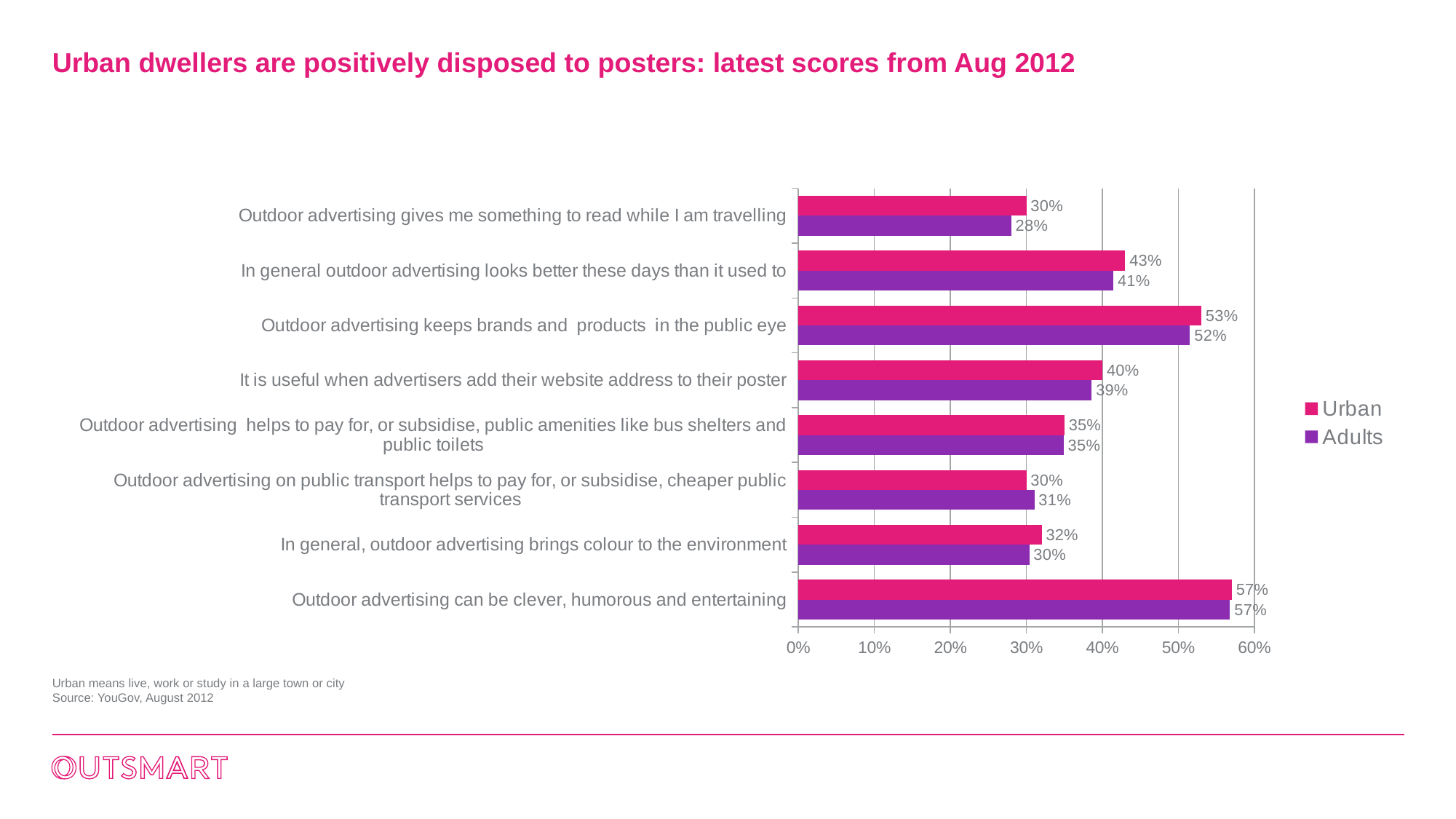
What is the Urban value for "Outdoor advertising keeps brands and products in the public eye"? 53% What is the difference between the Urban and Adults values for "In general outdoor advertising looks better these days than it used to"? 2% How many series does the legend list? 2 What is the Adults value for "It is useful when advertisers add their website address to their poster"? 39% Which statement has the highest Urban value? Outdoor advertising can be clever, humorous and entertaining How many statements (categories) are shown on the chart? 8 For "Outdoor advertising on public transport helps to pay for, or subsidise, cheaper public transport services", which is larger: the Urban value or the Adults value? Adults What kind of chart is shown on the slide? Bar chart Which statement has the lowest Adults value? Outdoor advertising gives me something to read while I am travelling Which series is shown in purple in the legend? Adults What is the Urban value for "In general, outdoor advertising brings colour to the environment"? 32% What is the Adults value for "Outdoor advertising gives me something to read while I am travelling"? 28%